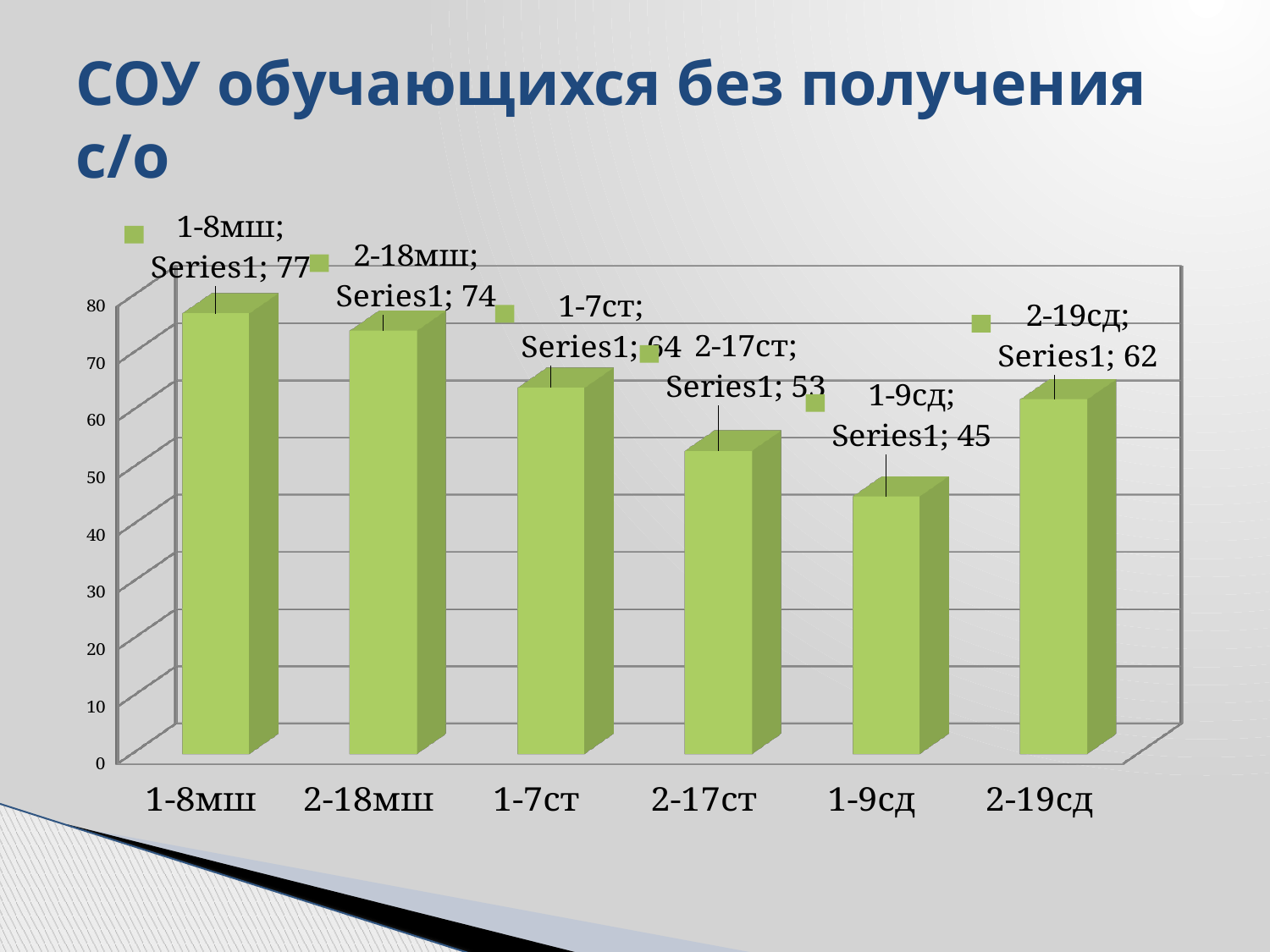
What is the value for 2-19сд? 62 What is the difference between the values for 1-8мш and 1-9сд? 32 Which category has the highest value? 1-8мш Is the value for 1-9сд greater or less than 50? less What is the title of the chart on the slide? СОУ обучающихся без получения с/о Which is larger, the value for 2-18мш or the value for 2-19сд? 2-18мш Which category has the lowest value? 1-9сд What kind of chart is shown on the slide? bar chart How many categories are shown on the x axis? 6 What is the value for 1-8мш? 77 What is the difference between the values for 1-7ст and 2-17ст? 11 What is the value for 2-17ст? 53